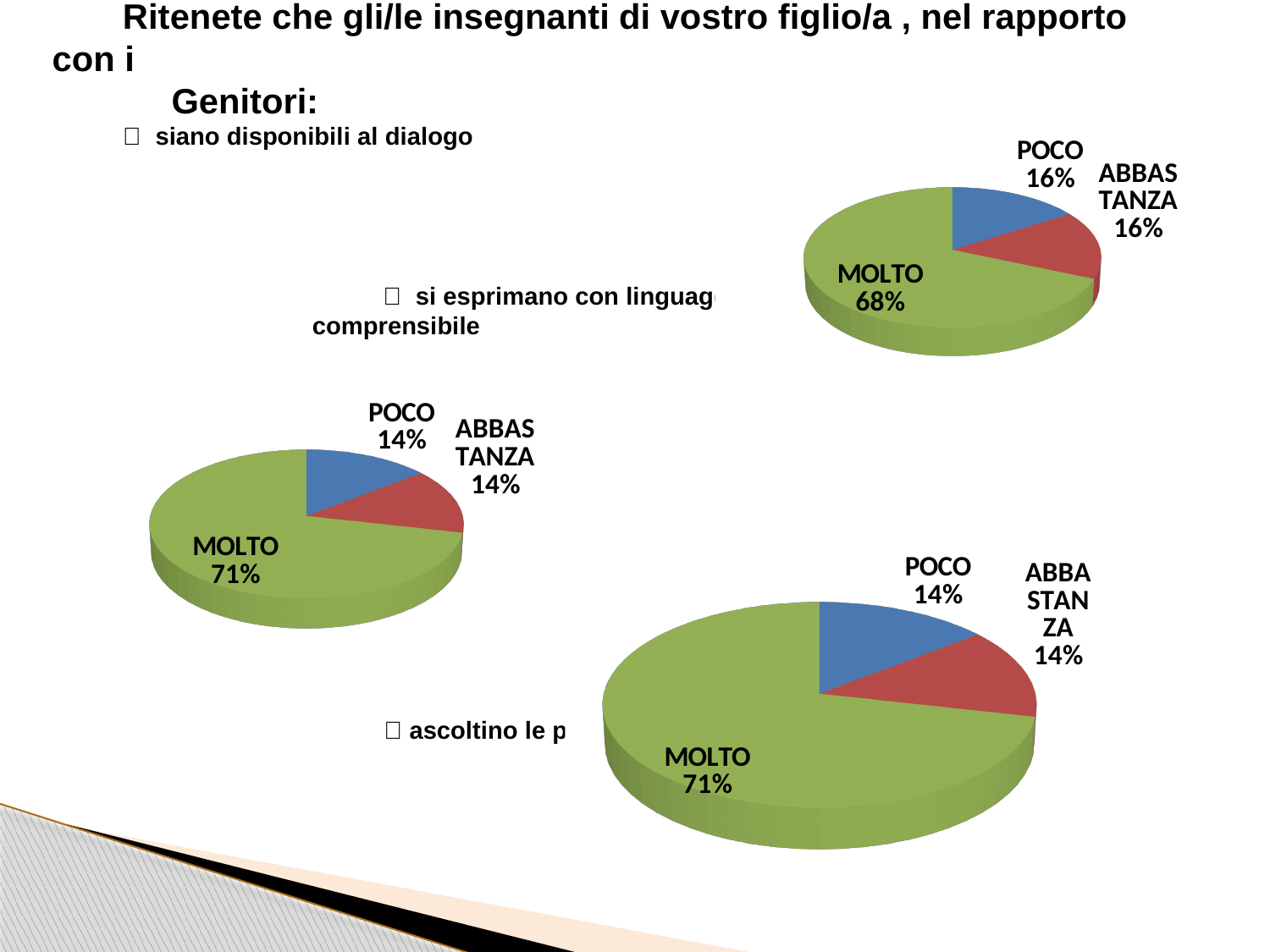
In the top-right pie chart, which category has the largest slice? MOLTO In the pie chart on the left of the slide, what percentage is shown for MOLTO? 71% In the top-right pie chart, what percentage is shown for MOLTO? 68% In the bottom-right pie chart, what percentage is shown for ABBASTANZA? 14% In the pie chart on the left of the slide, is the slice for MOLTO larger or smaller than the slice for ABBASTANZA? larger What type of chart is the chart on the left of the slide? pie chart How many slices does the bottom-right pie chart have? 3 In the bottom-right pie chart, which category has the largest slice? MOLTO In the pie chart on the left of the slide, what percentage is shown for POCO? 14% In the top-right pie chart, what is the difference in percentage points between MOLTO and POCO? 52 In the top-right pie chart, what percentage is shown for POCO? 16% In the top-right pie chart, what percentage is shown for ABBASTANZA? 16%